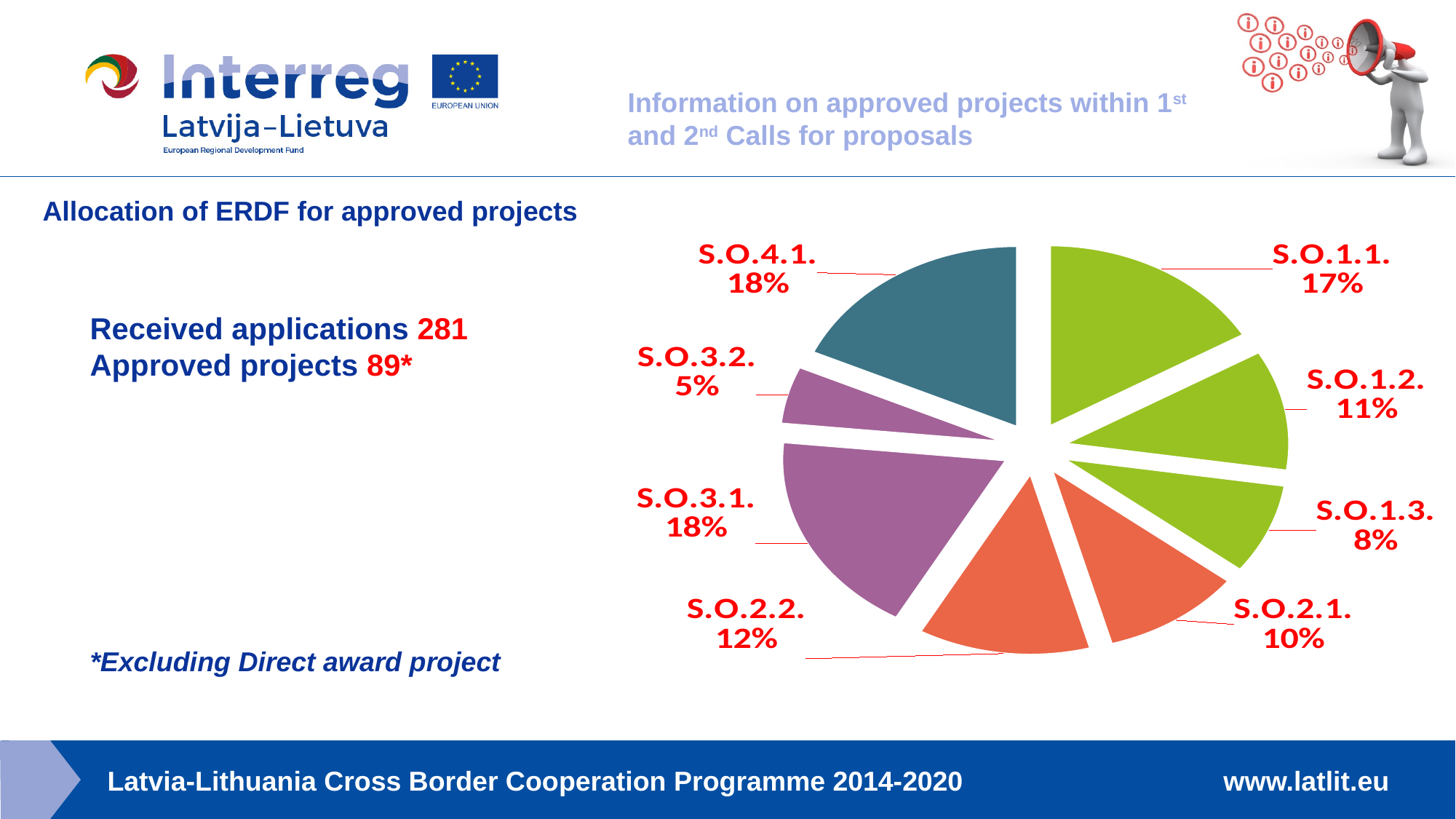
What share does S.O.1.3. have in the pie chart? 8% What is the difference in percentage points between S.O.3.1. and S.O.2.1.? 8 What is the value for S.O.2.2. in the pie chart? 12% What colour is the S.O.4.1. slice of the pie chart? Teal How many slices does the pie chart have? 8 What type of chart is shown on the slide? Pie chart What is the title of the chart on the slide? Allocation of ERDF for approved projects Which has a larger share, S.O.1.2. or S.O.2.2.? S.O.2.2. Which category has the smallest share of the pie? S.O.3.2. What share of ERDF allocation goes to S.O.1.1.? 17% Which has a larger share, S.O.1.1. or S.O.1.3.? S.O.1.1. What percentage is shown for S.O.3.2.? 5%